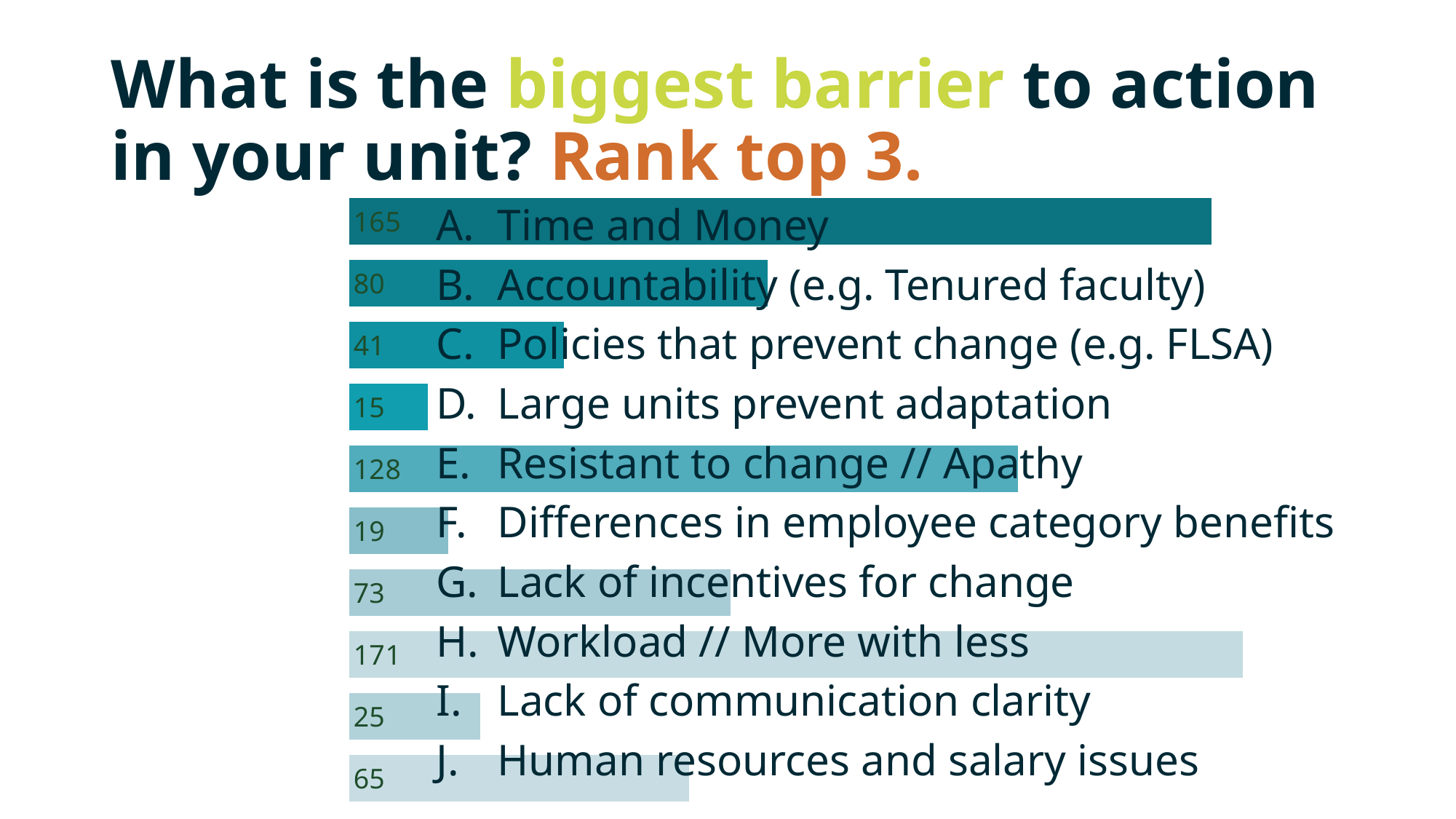
How many barrier categories are shown in the chart? 10 Which barrier has the lowest value? Large units prevent adaptation What kind of chart is shown on the slide? Bar chart Which barrier has the highest value? Workload // More with less What is the value for "Resistant to change // Apathy"? 128 What is the value for "Workload // More with less"? 171 What is the value for "Time and Money"? 165 What is the difference between the values for "Workload // More with less" and "Time and Money"? 6 Which has a larger value, "Human resources and salary issues" or "Policies that prevent change"? Human resources and salary issues What is the value for "Lack of communication clarity"? 25 What is the value for "Differences in employee category benefits"? 19 What is the difference between the values for "Accountability" and "Lack of incentives for change"? 7